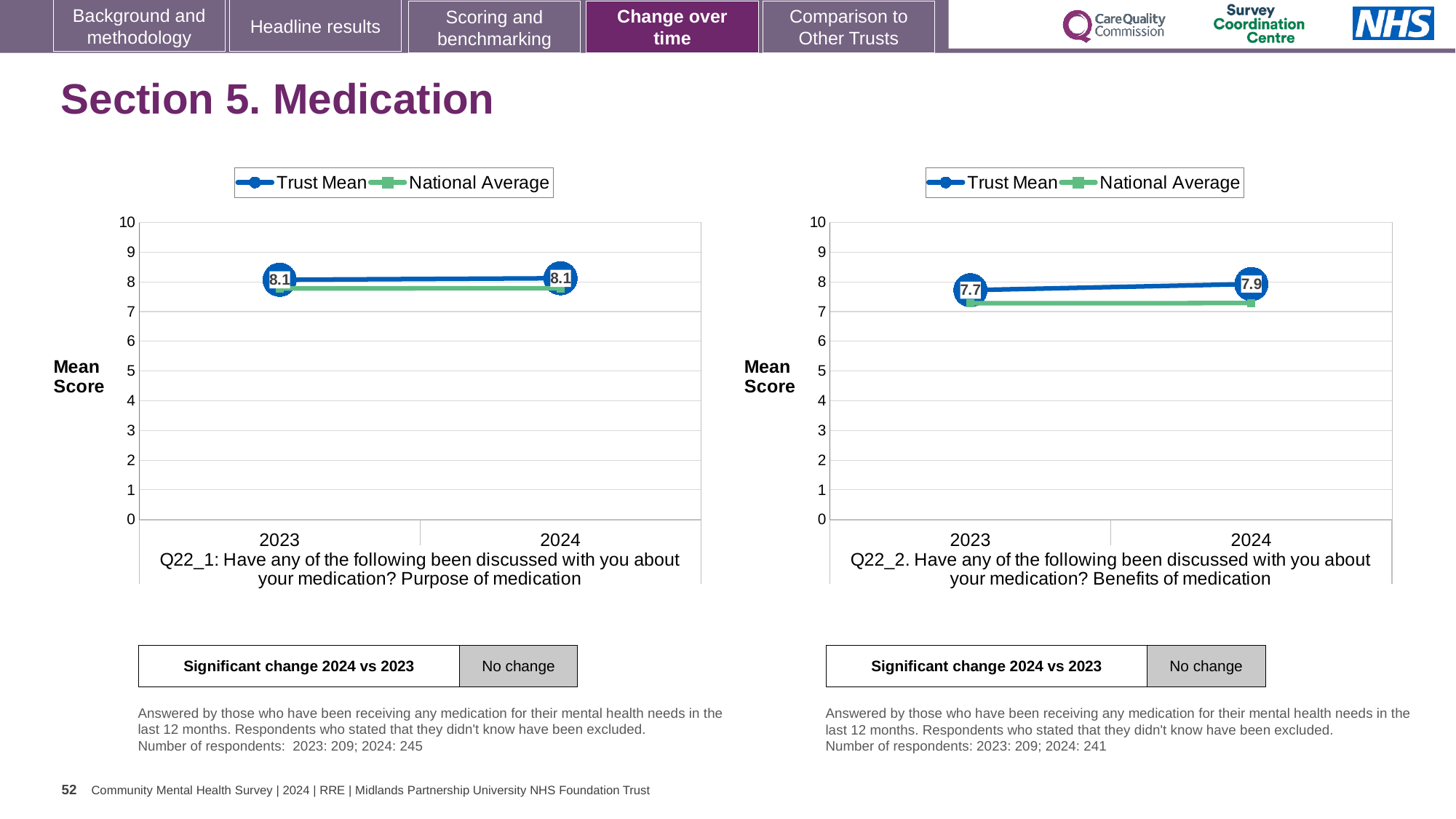
In the right chart (Q22_2: Benefits of medication), what is the Trust Mean score for 2024? 7.9 In the left chart (Q22_1: Purpose of medication), what is the Trust Mean score for 2024? 8.1 In the right chart (Q22_2: Benefits of medication), what is the Trust Mean score for 2023? 7.7 In the left chart (Q22_1: Purpose of medication), is the Trust Mean for 2024 greater or less than the National Average for 2024? greater How many series does the legend of the right chart (Q22_2: Benefits of medication) list? 2 In the right chart (Q22_2: Benefits of medication), is the National Average value for 2024 greater or less than 8? less In the right chart (Q22_2: Benefits of medication), which year has the higher Trust Mean, 2023 or 2024? 2024 In the left chart (Q22_1: Purpose of medication), what is the Trust Mean score for 2023? 8.1 How many years are plotted on the x axis of the left chart (Q22_1: Purpose of medication)? 2 In the right chart (Q22_2: Benefits of medication), by how much did the Trust Mean change from 2023 to 2024? 0.2 What kind of chart is the left chart (Q22_1: Purpose of medication)? Line chart In the right chart (Q22_2: Benefits of medication), does the Trust Mean rise or fall from 2023 to 2024? Rise